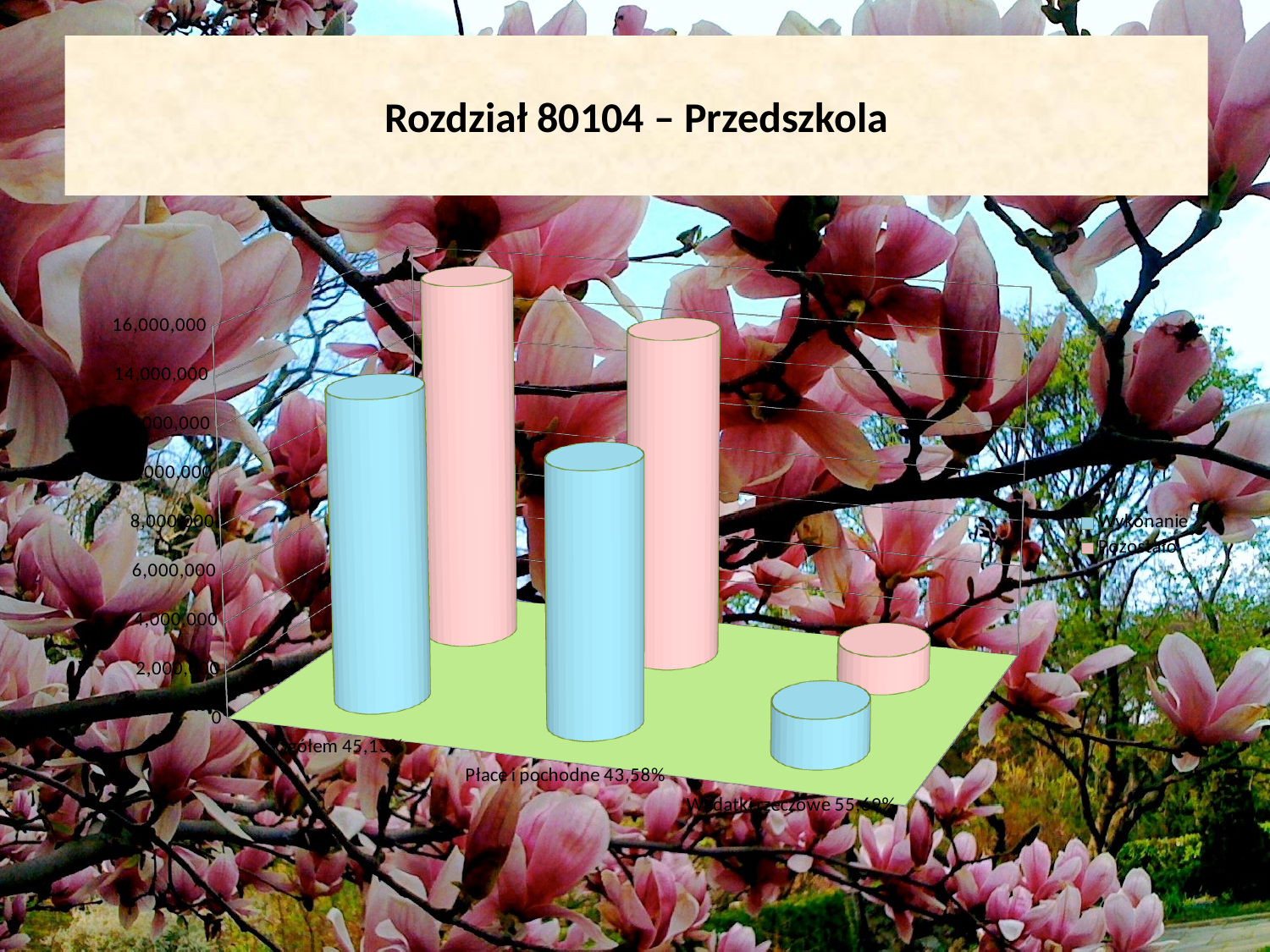
Which category has the highest Pozostało value? Ogółem What is the title of the slide containing the chart? Rozdział 80104 – Przedszkola Is the Pozostało value for Wydatki rzeczowe greater or less than 6,000,000? less How many categories are shown on the chart's x axis? 3 Is the Pozostało value for Ogółem greater or less than 10,000,000? greater Is the Wykonanie value for Płace i pochodne greater or less than 6,000,000? greater What are the two series named in the legend? Wykonanie and Pozostało How many series does the chart's legend list? 2 For Ogółem, which series has the larger value, Wykonanie or Pozostało? Pozostało What kind of chart is shown on the slide? bar chart